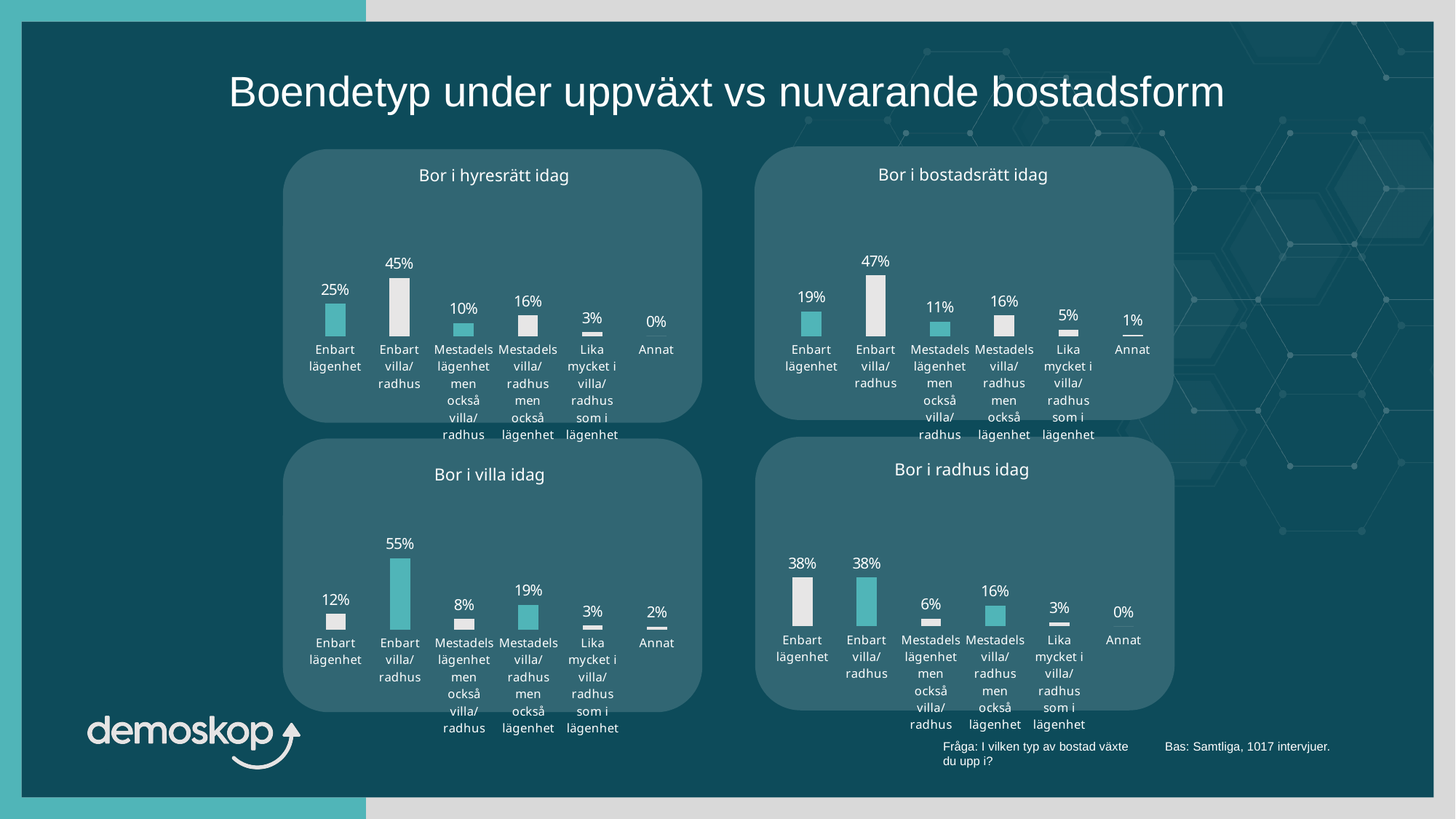
In the chart titled "Bor i villa idag", what is the value for "Mestadels villa/radhus men också lägenhet"? 19% How many categories does the chart titled "Bor i villa idag" show? 6 In the chart titled "Bor i radhus idag", what is the value for "Enbart lägenhet"? 38% How many charts are shown on the slide? 4 In the chart titled "Bor i radhus idag", what is the value for "Annat"? 0% In the chart titled "Bor i bostadsrätt idag", what is the value for "Enbart villa/radhus"? 47% In the chart titled "Bor i villa idag", which is larger: "Enbart lägenhet" or "Mestadels lägenhet men också villa/radhus"? Enbart lägenhet In the chart titled "Bor i hyresrätt idag", which category has the highest value? Enbart villa/radhus In the chart titled "Bor i hyresrätt idag", what is the value for "Enbart lägenhet"? 25% What kind of chart is "Bor i bostadsrätt idag"? Bar chart In the chart titled "Bor i bostadsrätt idag", what is the difference between "Enbart villa/radhus" and "Enbart lägenhet"? 28 percentage points In the chart titled "Bor i hyresrätt idag", which category has the lowest value? Annat